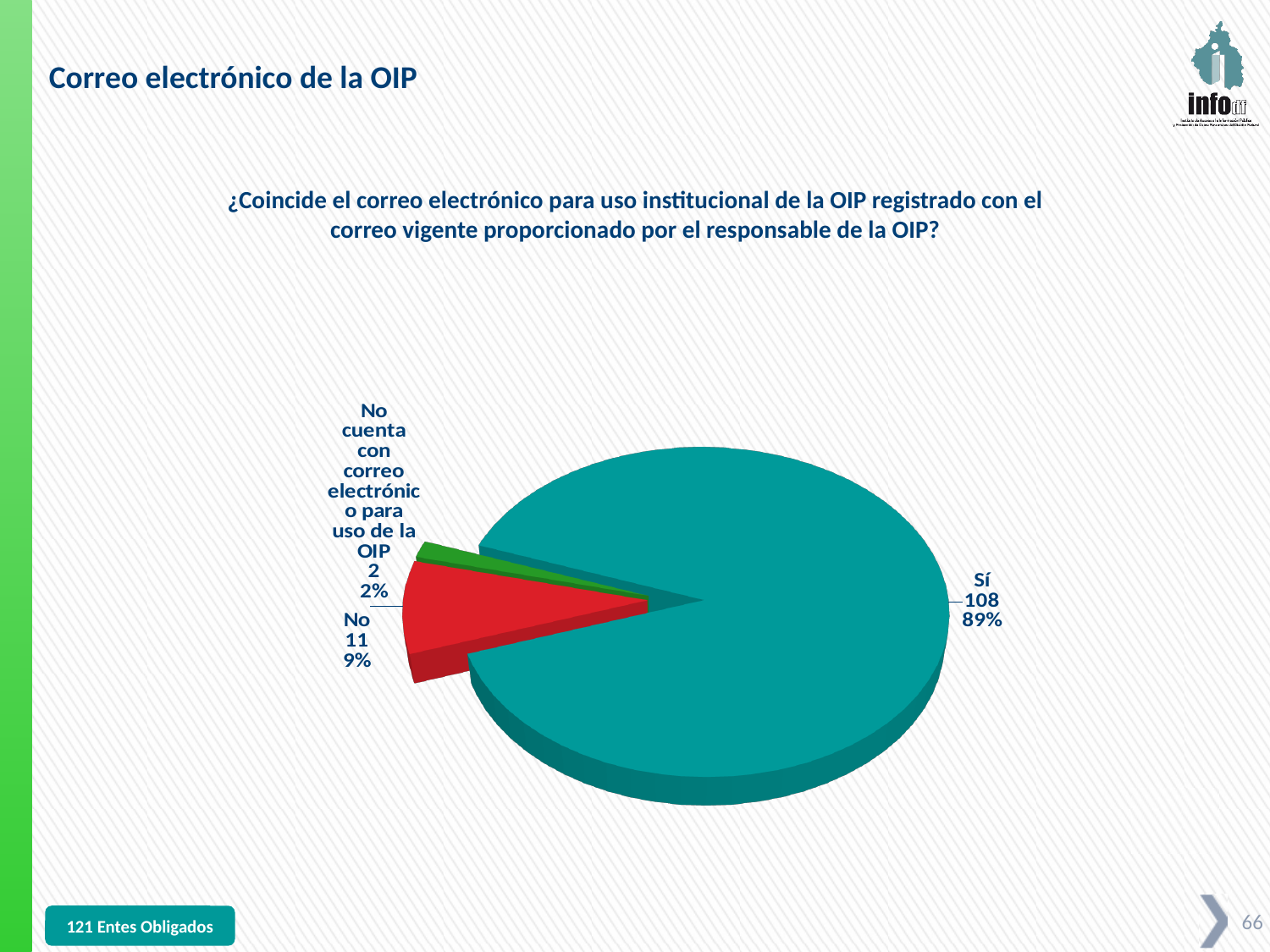
Which is larger, the 'No' slice or the 'No cuenta con correo electrónico para uso de la OIP' slice? No What kind of chart is shown on the slide? Pie chart What is the value for the 'Sí' slice? 108 How many slices does the pie chart have? 3 What share of the pie does the 'No cuenta con correo electrónico para uso de la OIP' slice represent? 2% What is the difference between the 'Sí' and 'No' values? 97 What share of the pie does the 'Sí' slice represent? 89% Which slice is the smallest? No cuenta con correo electrónico para uso de la OIP What share of the pie does the 'No' slice represent? 9% What is the value for the 'No cuenta con correo electrónico para uso de la OIP' slice? 2 What is the value for the 'No' slice? 11 Which slice is the largest? Sí